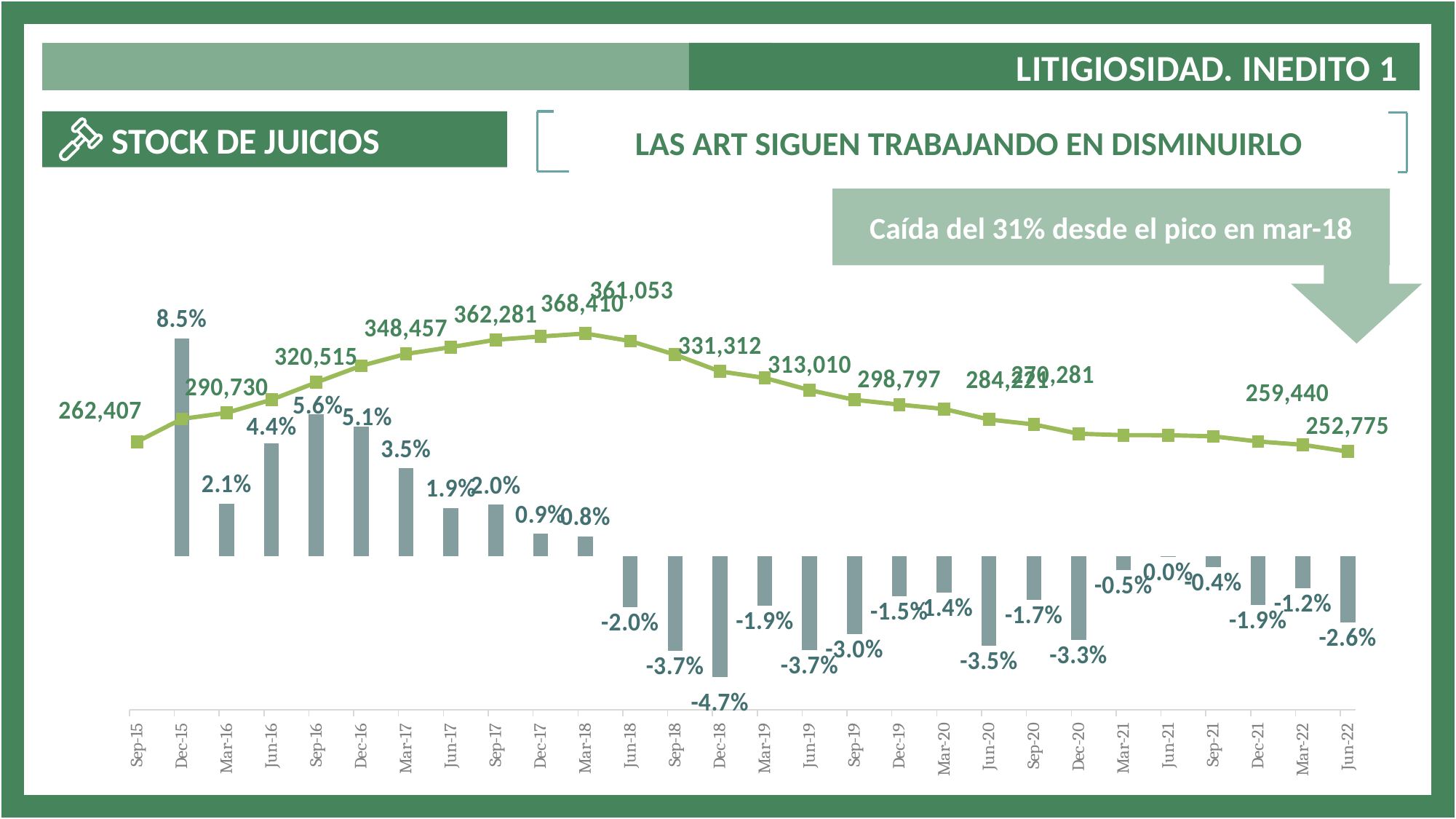
Which period has the highest bar (percentage change)? Dec-15 How many quarterly periods are labelled on the x axis of the chart? 28 Which bar is larger, Jun-16 or Dec-16? Dec-16 Does the line series rise or fall from Mar-18 to Jun-22? Fall Which period has the lowest bar (percentage change)? Dec-18 What kind of chart is shown on the slide? A combined line and bar chart What is the value of the line series at Sep-15? 262,407 What is the highest value labelled on the line series? 368,410 What is the percentage change shown by the bar for Sep-16? 5.6% What is the difference between the line value at Sep-15 (262,407) and at Jun-22 (252,775)? 9,632 What is the percentage change shown by the bar for Jun-22? -2.6% What is the value of the line series at Jun-22? 252,775